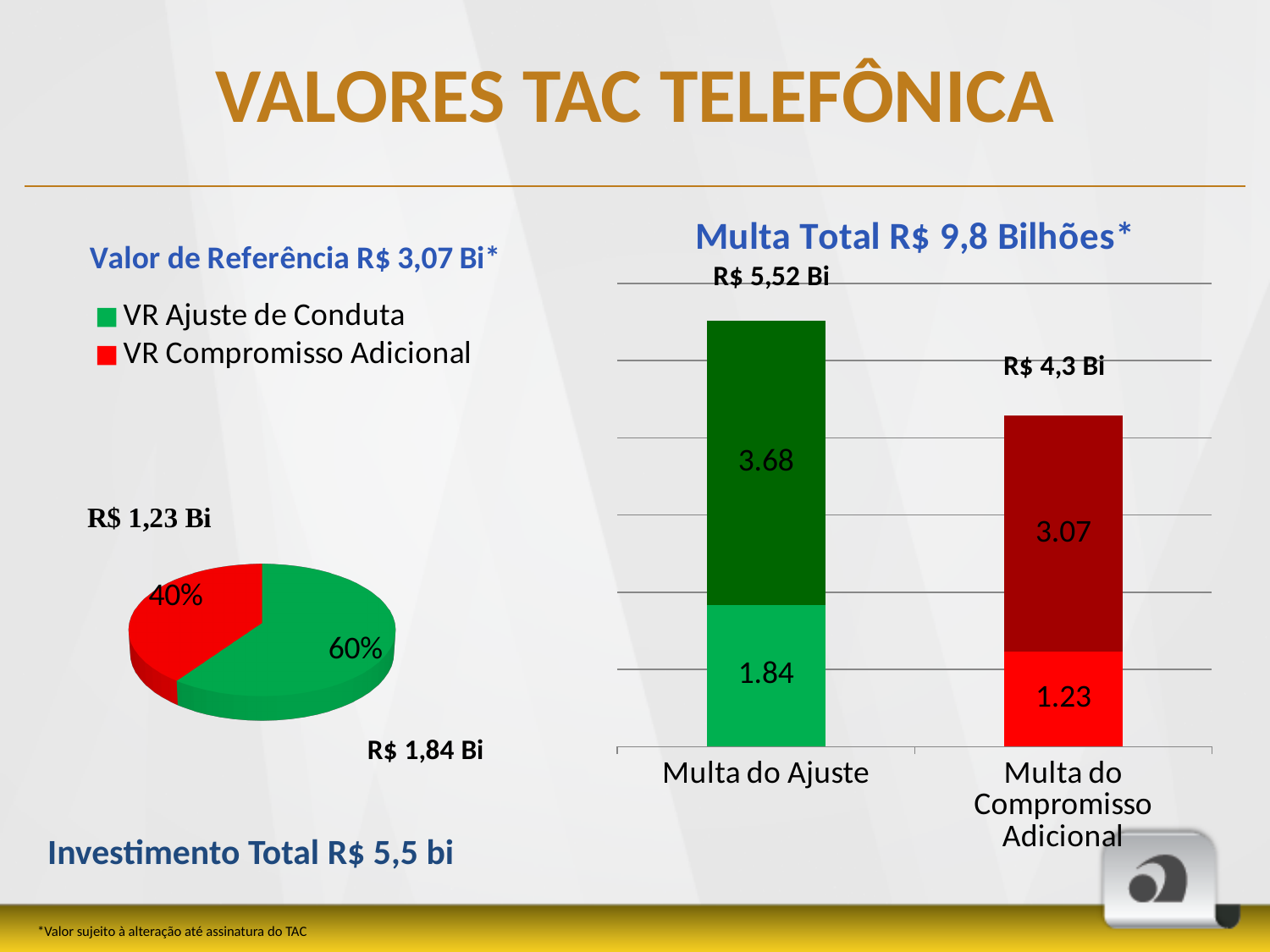
In the bar chart on the right, what is the value of the upper (dark green) segment of the Multa do Ajuste bar? 3.68 In the bar chart on the right, what is the total labelled above the Multa do Ajuste bar? R$ 5,52 Bi What kind of chart is the one on the right titled 'Multa Total R$ 9,8 Bilhões*'? bar chart In the bar chart on the right, what is the value of the upper (dark red) segment of the Multa do Compromisso Adicional bar? 3.07 In the pie chart on the left, what share does VR Compromisso Adicional (red) have? 40% In the pie chart on the left, which slice is larger, VR Ajuste de Conduta or VR Compromisso Adicional? VR Ajuste de Conduta What kind of chart is the one on the left titled 'Valor de Referência R$ 3,07 Bi*'? pie chart How many entries does the legend of the pie chart on the left list? 2 In the bar chart on the right, what is the value of the lower (light green) segment of the Multa do Ajuste bar? 1.84 In the pie chart on the left, what share does VR Ajuste de Conduta (green) have? 60% In the bar chart on the right, which bar is taller, Multa do Ajuste or Multa do Compromisso Adicional? Multa do Ajuste In the bar chart on the right, what is the total labelled above the Multa do Compromisso Adicional bar? R$ 4,3 Bi